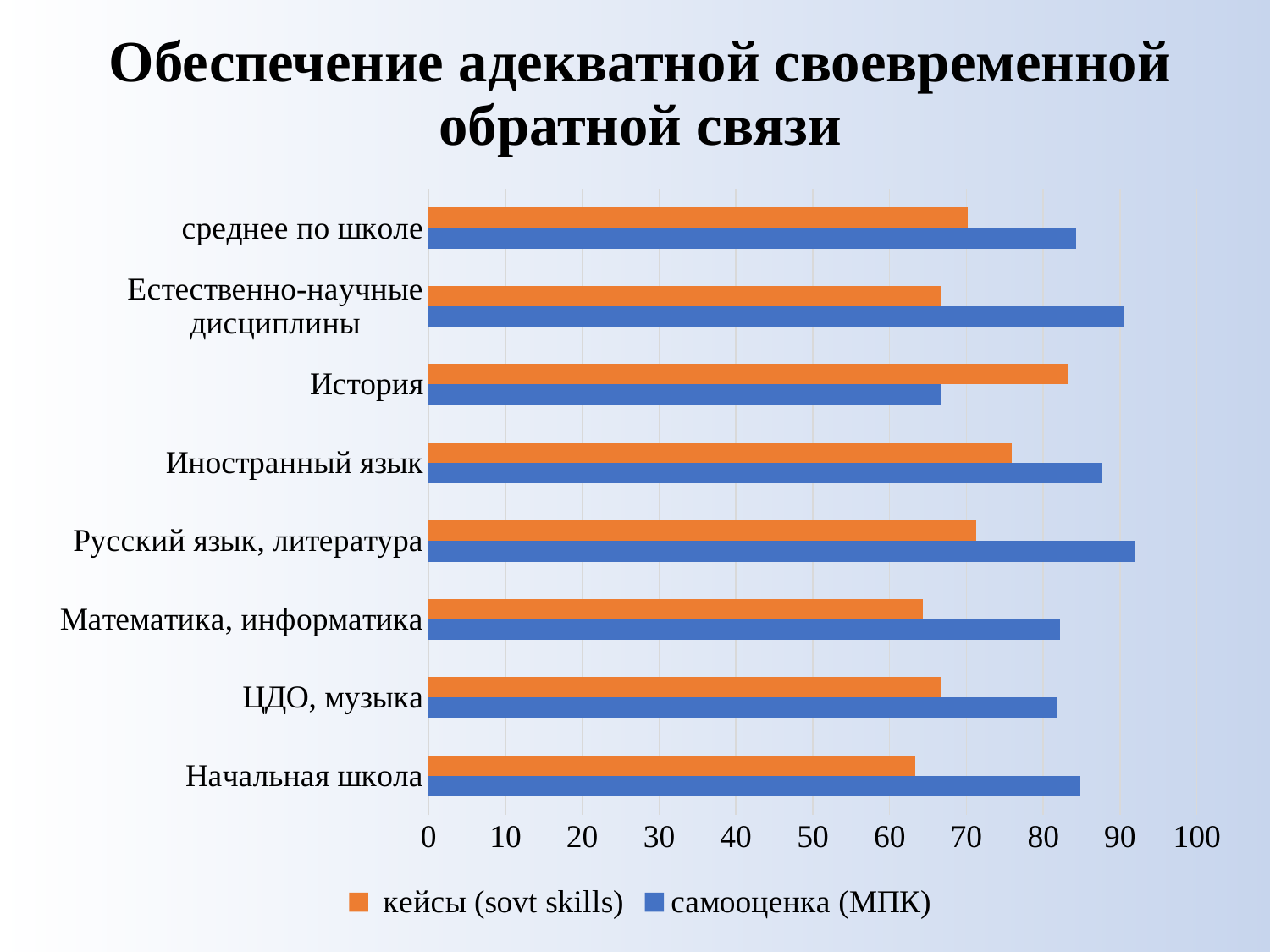
Is the value of самооценка (МПК) for История greater or less than 70? less Is the value of самооценка (МПК) for Естественно-научные дисциплины greater or less than 80? greater Which category has the lowest value for the series самооценка (МПК)? История For История, which series has the larger value: кейсы (sovt skills) or самооценка (МПК)? кейсы (sovt skills) How many categories are shown on the vertical axis of the chart? 8 What colour are the bars for the series самооценка (МПК)? blue What kind of chart is shown on the slide? bar chart Is the value of кейсы (sovt skills) for Начальная школа greater or less than 70? less Which category has the highest value for the series кейсы (sovt skills)? История For среднее по школе, which series has the larger value: кейсы (sovt skills) or самооценка (МПК)? самооценка (МПК) How many series does the legend list? 2